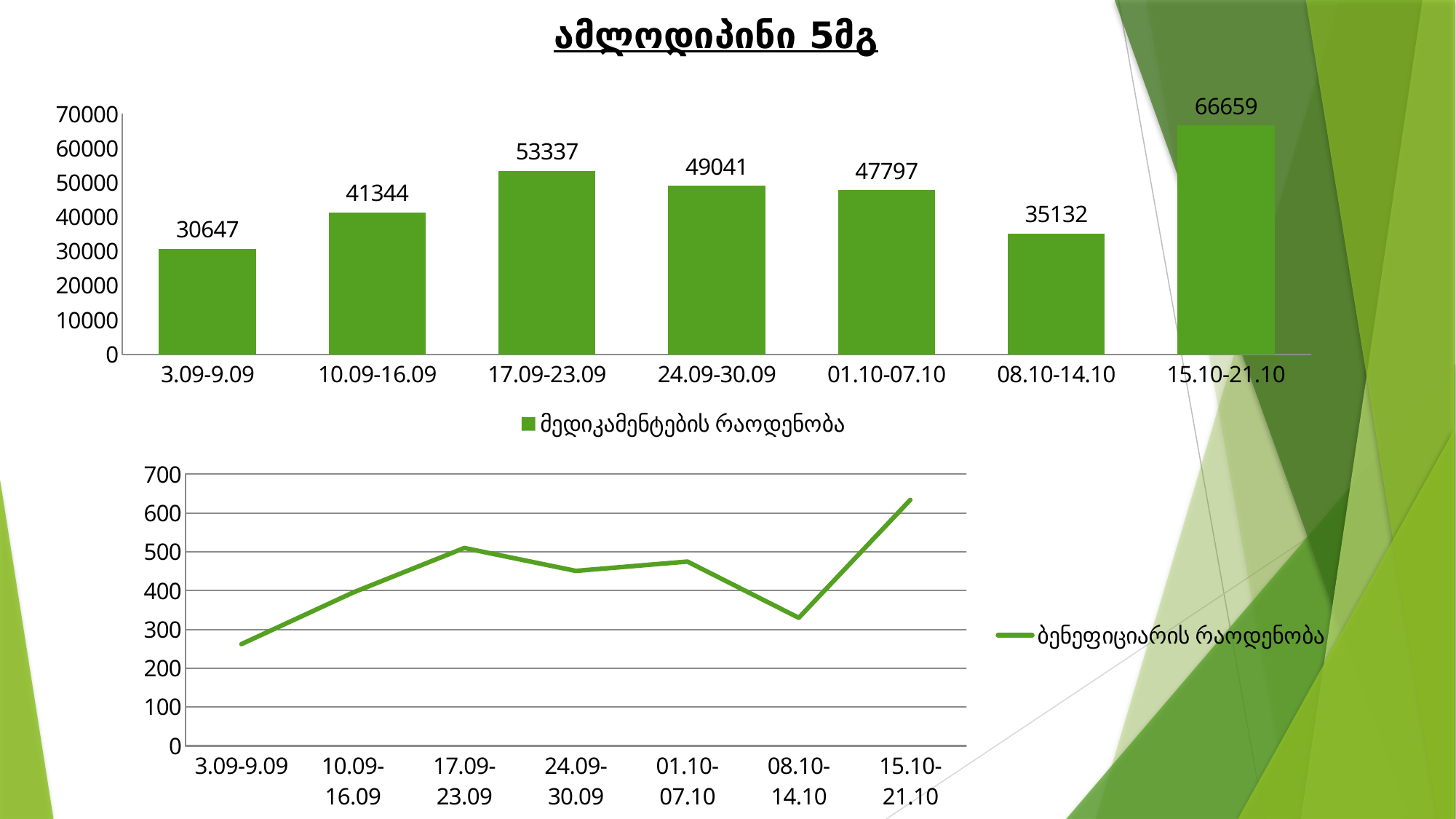
In the top bar chart, which period has the highest value? 15.10-21.10 In the top bar chart, which is larger: the value for 24.09-30.09 or the value for 01.10-07.10? 24.09-30.09 How many periods are shown in the top bar chart? 7 In the bottom line chart, is the value for 15.10-21.10 greater or less than 600? greater In the top bar chart, what is the value for 3.09-9.09? 30647 What kind of chart is the bottom chart on the slide? Line chart In the bottom line chart, is the value for 08.10-14.10 greater or less than 400? less In the bottom line chart, which period has the highest value? 15.10-21.10 In the top bar chart, which period has the lowest value? 3.09-9.09 In the top bar chart, what is the difference between the values for 17.09-23.09 and 10.09-16.09? 11993 In the top bar chart, what is the value for 08.10-14.10? 35132 In the top bar chart, what is the value for 15.10-21.10? 66659